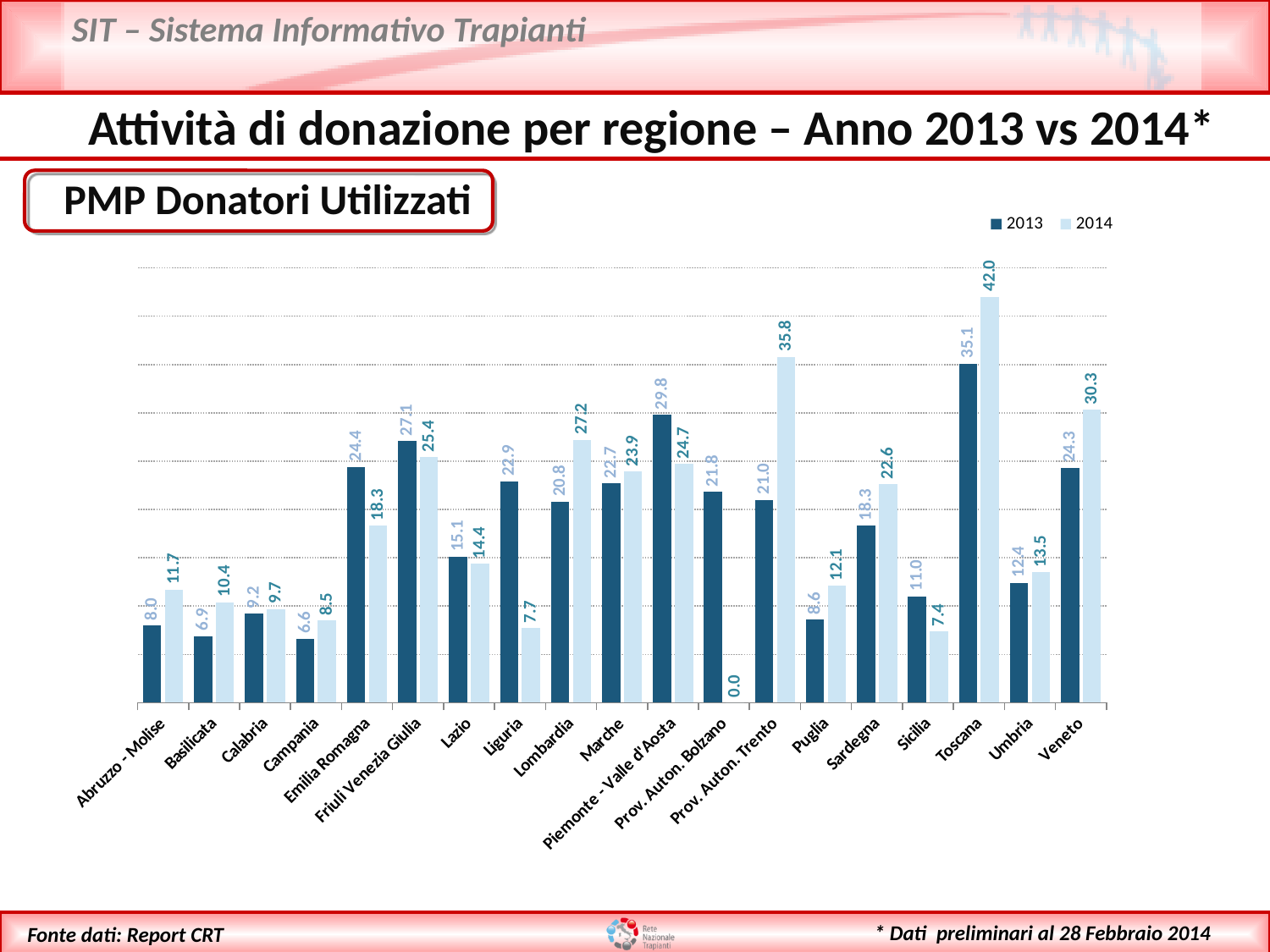
What is the 2013 value for Liguria? 22.9 Which region has the highest 2014 value? Toscana What kind of chart is shown on the slide? Bar chart Which region has the lowest 2013 value? Campania How many regions are shown on the x axis? 19 What is the difference between the 2013 and 2014 values for Liguria? 15.2 What is the 2014 value for Toscana? 42.0 What is the 2014 value for Prov. Auton. Bolzano? 0.0 How many series does the legend list? 2 Which is larger for Prov. Auton. Trento, the 2013 value or the 2014 value? 2014 What is the 2013 value for Piemonte - Valle d'Aosta? 29.8 What is the difference between the 2014 and 2013 values for Toscana? 6.9